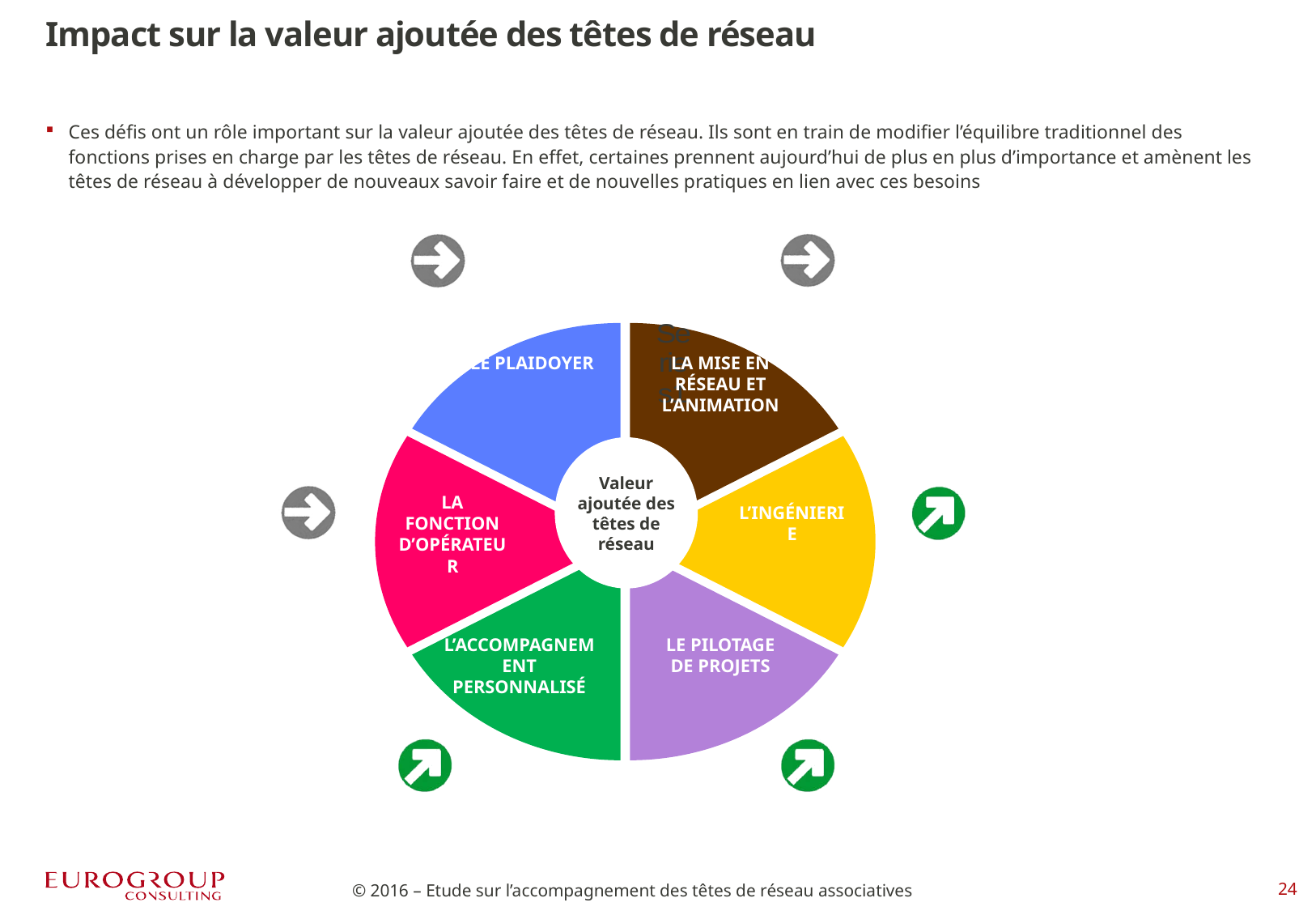
Which segment of the doughnut chart is labelled in the bottom-right position? LE PILOTAGE DE PROJETS What text appears in the centre of the doughnut chart? Valeur ajoutée des têtes de réseau Which segment of the doughnut chart is labelled in the top-left position? LE PLAIDOYER Which segment of the doughnut chart is coloured yellow? L'INGÉNIERIE What kind of chart is shown on the slide? Doughnut chart How many segments does the doughnut chart have? 6